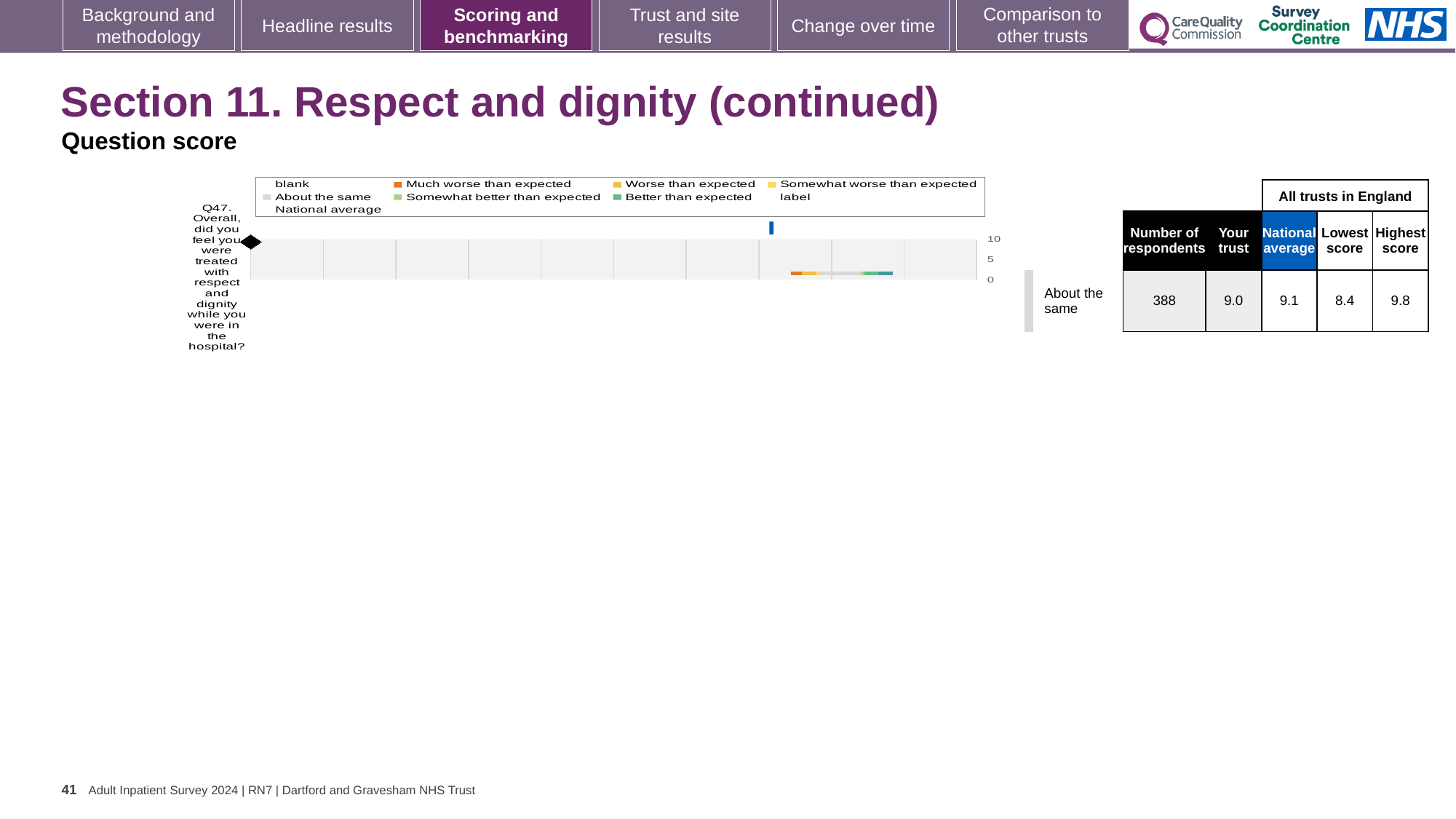
What kind of chart is shown for Q47 on the slide? bar chart According to the table beside the chart, how many respondents answered Q47? 388 Which is larger for Q47: the 'Your trust' score or the national average? National average According to the table beside the chart, what is the 'Your trust' score for Q47? 9.0 How many entries does the chart legend list? 9 According to the table beside the chart, what is the lowest score among all trusts in England for Q47? 8.4 According to the table beside the chart, what is the highest score among all trusts in England for Q47? 9.8 How many questions (categories) are plotted in the chart? 1 According to the table beside the chart, what is the national average score for Q47? 9.1 What is the highest value shown on the chart's axis? 10 What is the difference between the highest score and the lowest score for Q47 in the table beside the chart? 1.4 Which question is plotted in the chart? Q47. Overall, did you feel you were treated with respect and dignity while you were in the hospital?